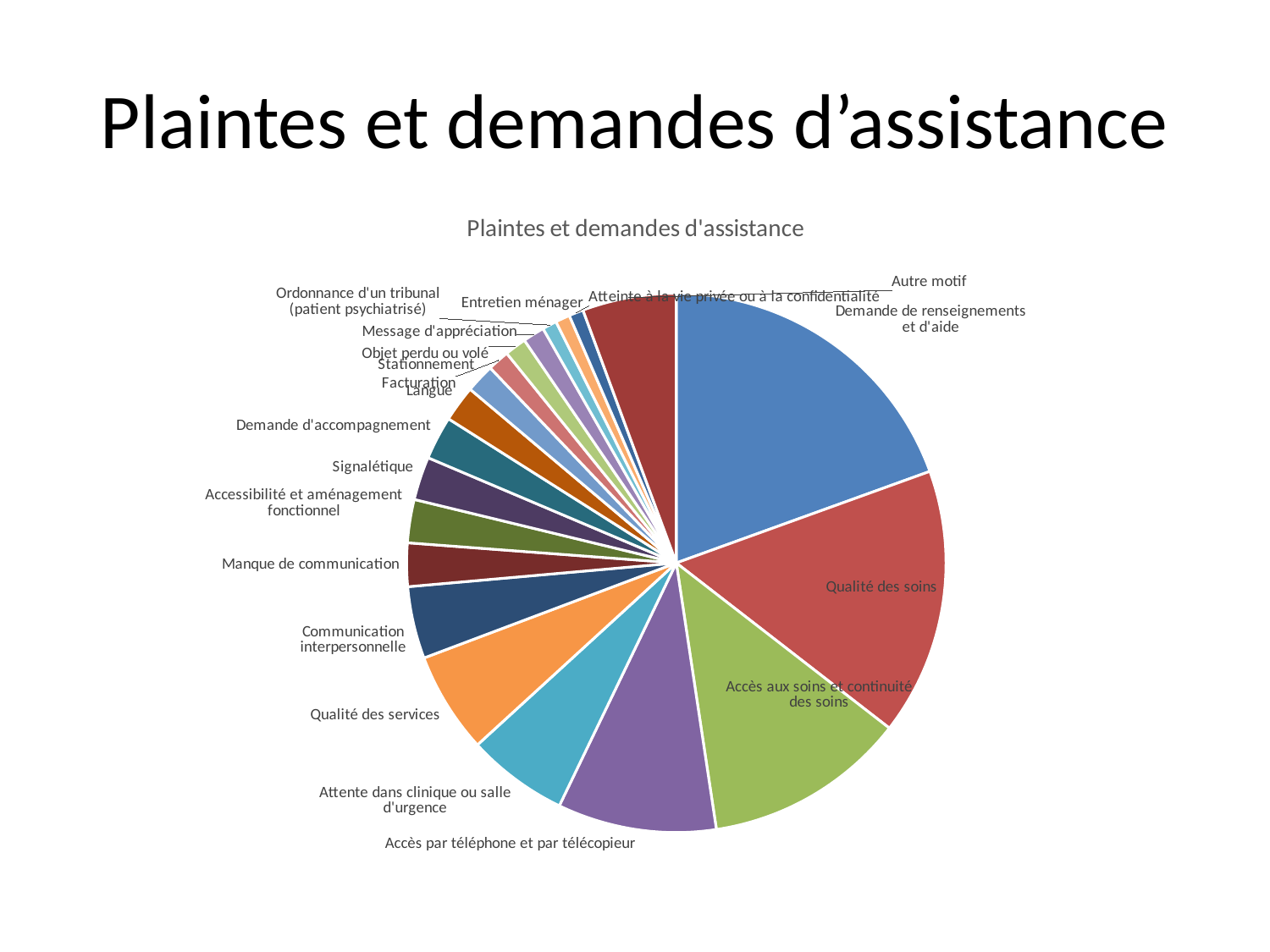
Which slice is larger: Accès aux soins et continuité des soins or Qualité des services? Accès aux soins et continuité des soins Which slice is larger: Demande de renseignements et d'aide or Signalétique? Demande de renseignements et d'aide Which category has the largest slice of the pie? Demande de renseignements et d'aide What colour is the slice for Qualité des soins? red What is the title of the chart? Plaintes et demandes d'assistance Which slice is larger: Qualité des soins or Attente dans clinique ou salle d'urgence? Qualité des soins What kind of chart is shown on the slide? pie chart